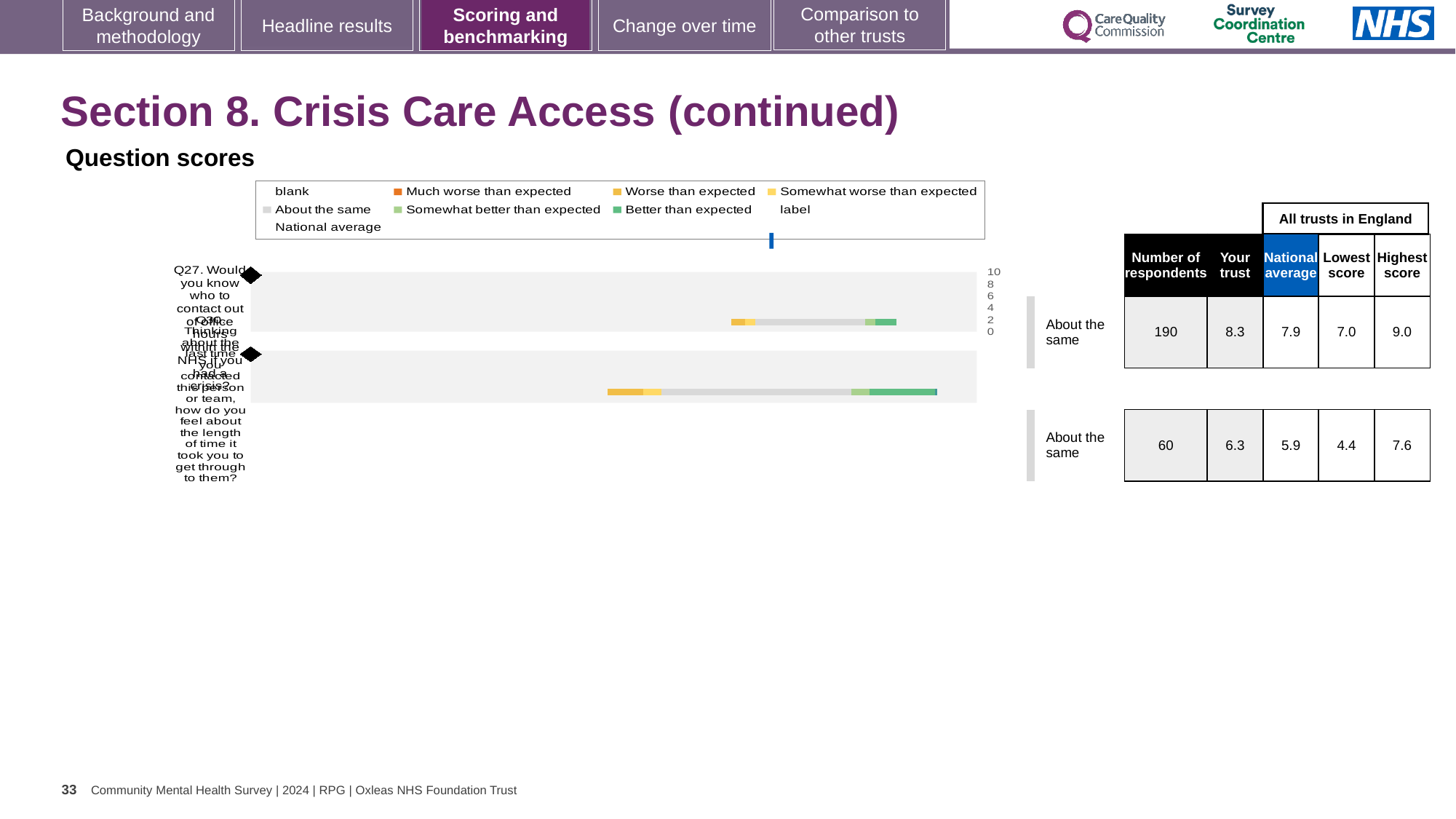
What benchmark category is shown for Q30 in the question scores chart? About the same Which question has the higher 'Your trust' score, Q27 or Q30? Q27 What type of chart is used to show the question scores on this slide? Bar chart What is the highest score across all trusts in England for Q27? 9.0 How many respondents answered Q27 according to the table? 190 What is the lowest score across all trusts in England for Q30? 4.4 What is the 'Your trust' score for Q27 in the question scores table? 8.3 How many respondents answered Q30 according to the table? 60 How many questions (bars) are plotted in the question scores chart? 2 What is the difference between the 'Your trust' score and the national average for Q27? 0.4 What is the difference between the highest and lowest scores across all trusts in England for Q30? 3.2 What is the national average score for Q30 in the question scores table? 5.9